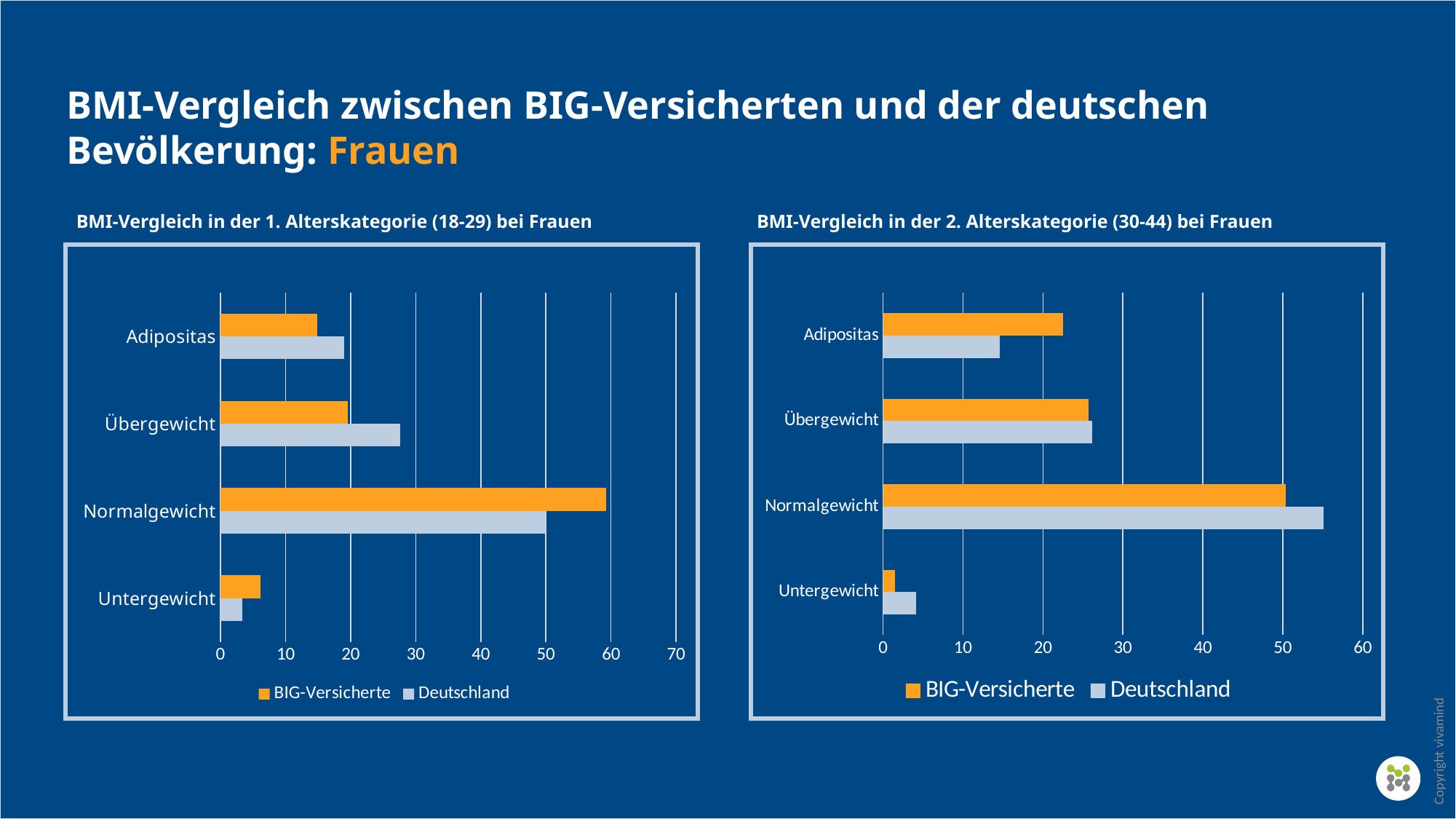
Which colour represents the Deutschland series in the charts? light blue On the left chart (18-29), which is larger for Übergewicht: BIG-Versicherte or Deutschland? Deutschland On the right chart (30-44), which category has the lowest value for BIG-Versicherte? Untergewicht On the left chart (18-29), is the BIG-Versicherte value for Normalgewicht greater or less than 50? greater What kind of chart is the left chart, 'BMI-Vergleich in der 1. Alterskategorie (18-29) bei Frauen'? bar chart How many series does the legend of the right chart (30-44) list? 2 On the left chart (18-29), which category has the lowest value for Deutschland? Untergewicht On the left chart (18-29), which category has the highest value for BIG-Versicherte? Normalgewicht How many categories are shown on the left chart (18-29)? 4 On the right chart (30-44), is the Deutschland value for Normalgewicht greater or less than 50? greater On the right chart (30-44), which is larger for Adipositas: BIG-Versicherte or Deutschland? BIG-Versicherte On the right chart (30-44), is the BIG-Versicherte value for Untergewicht greater or less than 10? less